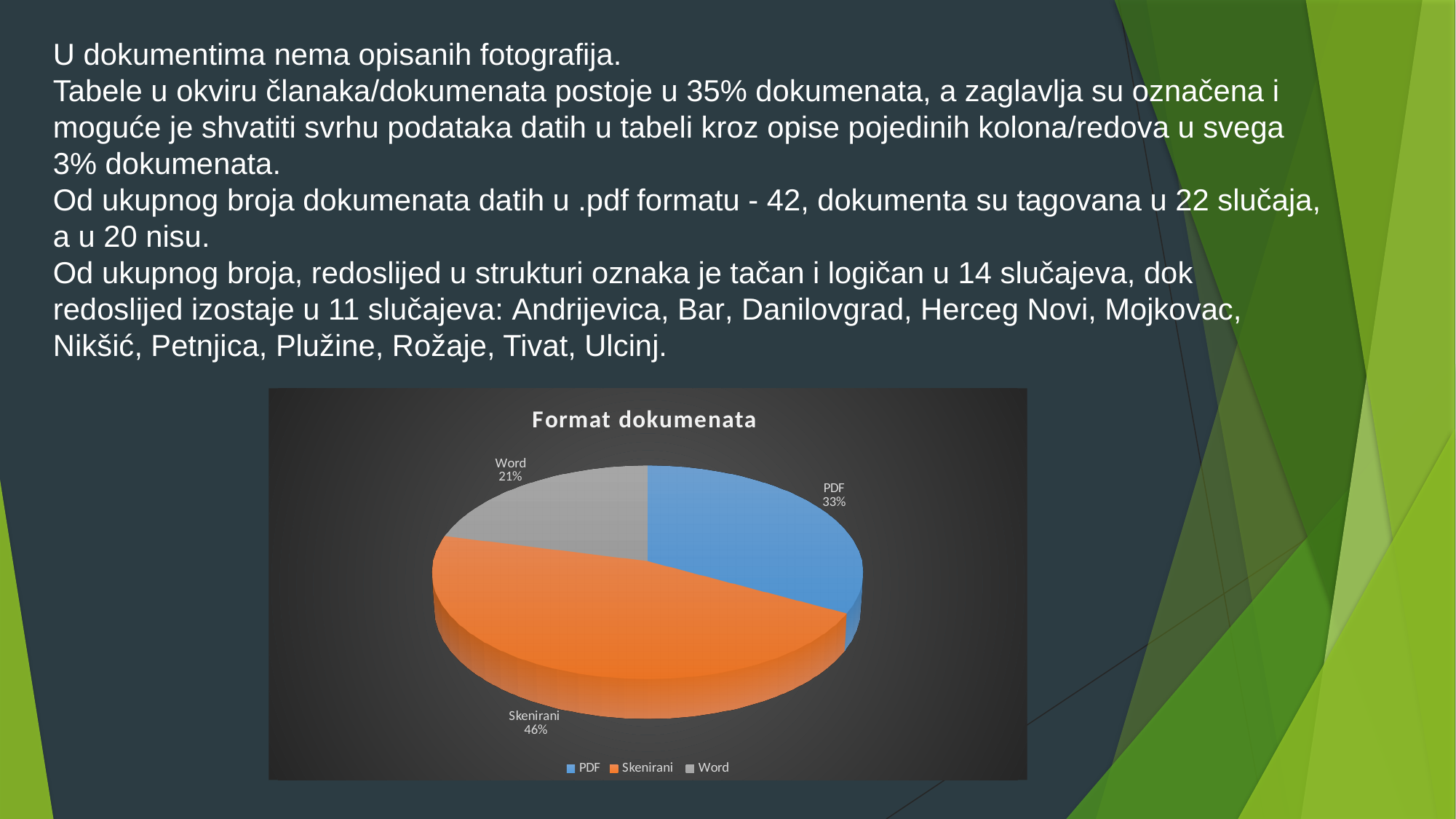
What is the difference in percentage points between Skenirani and PDF? 13 What is the title of the chart? Format dokumenata What share of the pie does Word have? 21% What kind of chart is shown on the slide? pie chart Which is larger, the share for PDF or the share for Word? PDF What share of the pie does PDF have? 33% What share of the pie does Skenirani have? 46% Which colour represents Skenirani in the chart? orange What is the difference in percentage points between PDF and Word? 12 Which category has the smallest slice of the pie? Word Which category has the largest slice of the pie? Skenirani How many categories are shown in the pie chart? 3